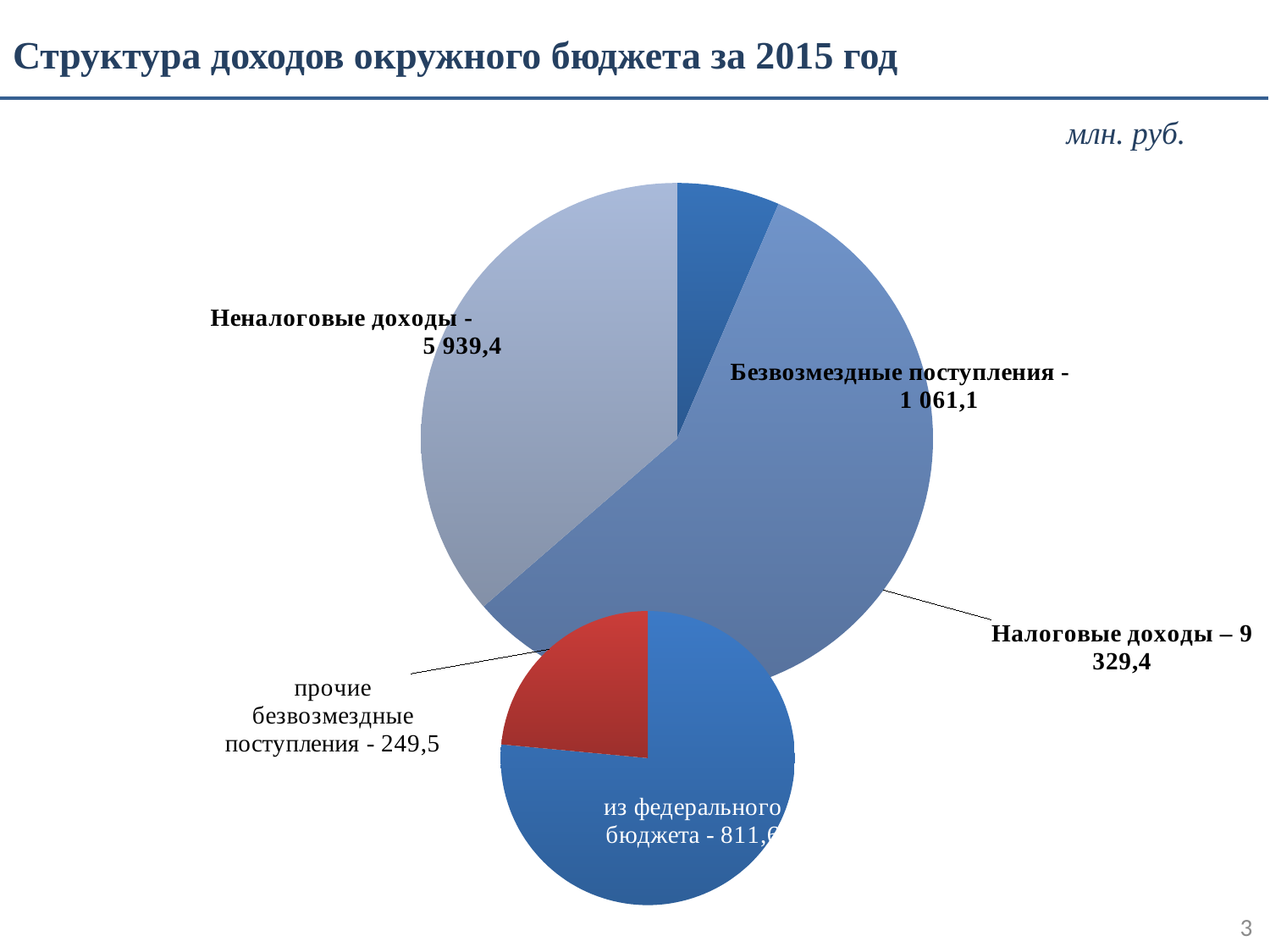
In the main pie chart, what is the value for Неналоговые доходы? 5 939,4 In the main pie chart, what is the value for Налоговые доходы? 9 329,4 In the main pie chart, what is the value for Безвозмездные поступления? 1 061,1 In the smaller pie chart, what is the value for прочие безвозмездные поступления? 249,5 Which category has the smallest slice in the main pie chart? Безвозмездные поступления What unit of measurement is indicated for the values on the slide? млн. руб. In the main pie chart, which is larger: Неналоговые доходы or Безвозмездные поступления? Неналоговые доходы What kind of chart is shown on the slide? pie chart In the main pie chart, how much larger is Налоговые доходы than Неналоговые доходы? 3 390,0 Which category has the largest slice in the main pie chart? Налоговые доходы In the smaller pie chart, which slice is larger: из федерального бюджета or прочие безвозмездные поступления? из федерального бюджета How many slices does the main pie chart have? 3